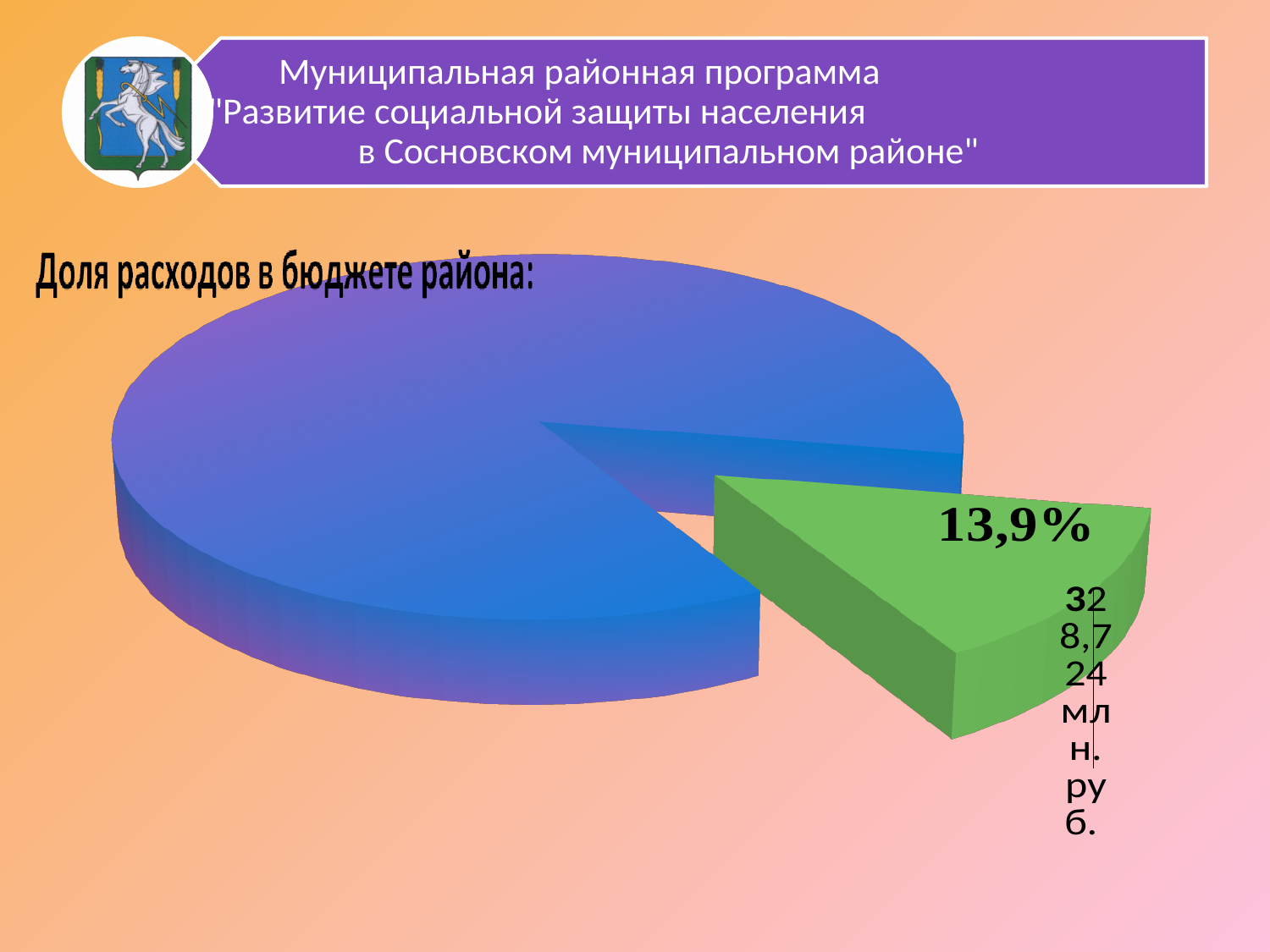
What is the title of the pie chart? Доля расходов в бюджете района: What colour is the exploded slice labelled 13,9%? green What share of the pie does the green (exploded) slice represent? 13,9% What kind of chart is shown on the slide? pie chart How many slices does the pie chart have? 2 Which slice of the pie chart is larger, the blue one or the green one? the blue one What amount in millions of roubles is printed next to the green slice? 328,724 млн. руб. Which slice of the pie chart is the smallest? the green slice (13,9%)